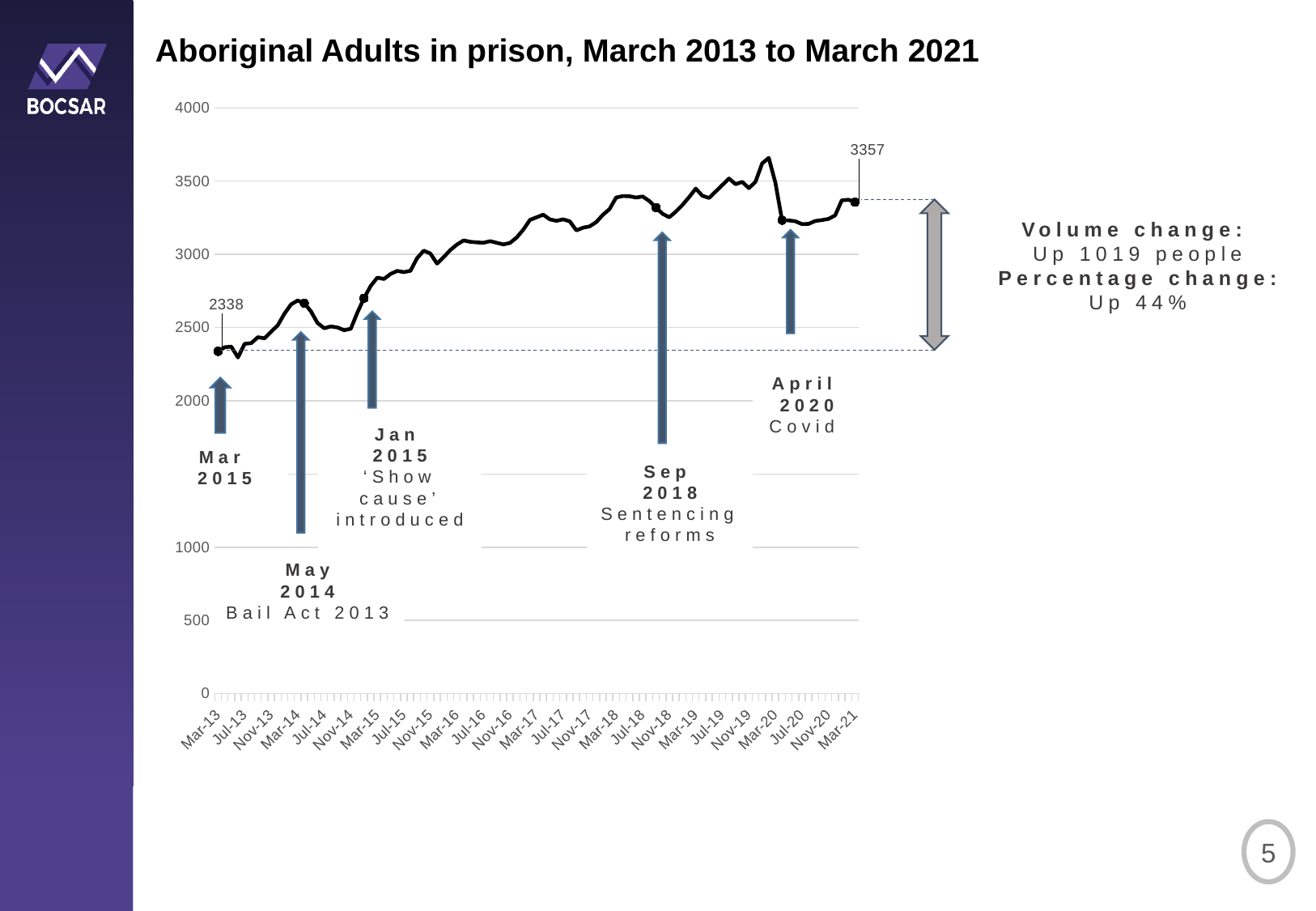
Is the value for Mar-14 greater or less than 2500? greater What is the value for Mar-13 on the chart? 2338 What kind of chart is shown on the slide? Line chart What is the title of the chart? Aboriginal Adults in prison, March 2013 to March 2021 Is the value for Jul-20 greater or less than 3500? less What is the difference between the Mar-21 value and the Mar-13 value? 1019 Which is larger, the value for Mar-13 or the value for Mar-21? Mar-21 What percentage change is stated next to the chart? Up 44% Do the values generally rise or fall from Mar-13 to Mar-21? Rise What is the value for Mar-21 on the chart? 3357 Is the value for Mar-13 greater or less than 2500? less